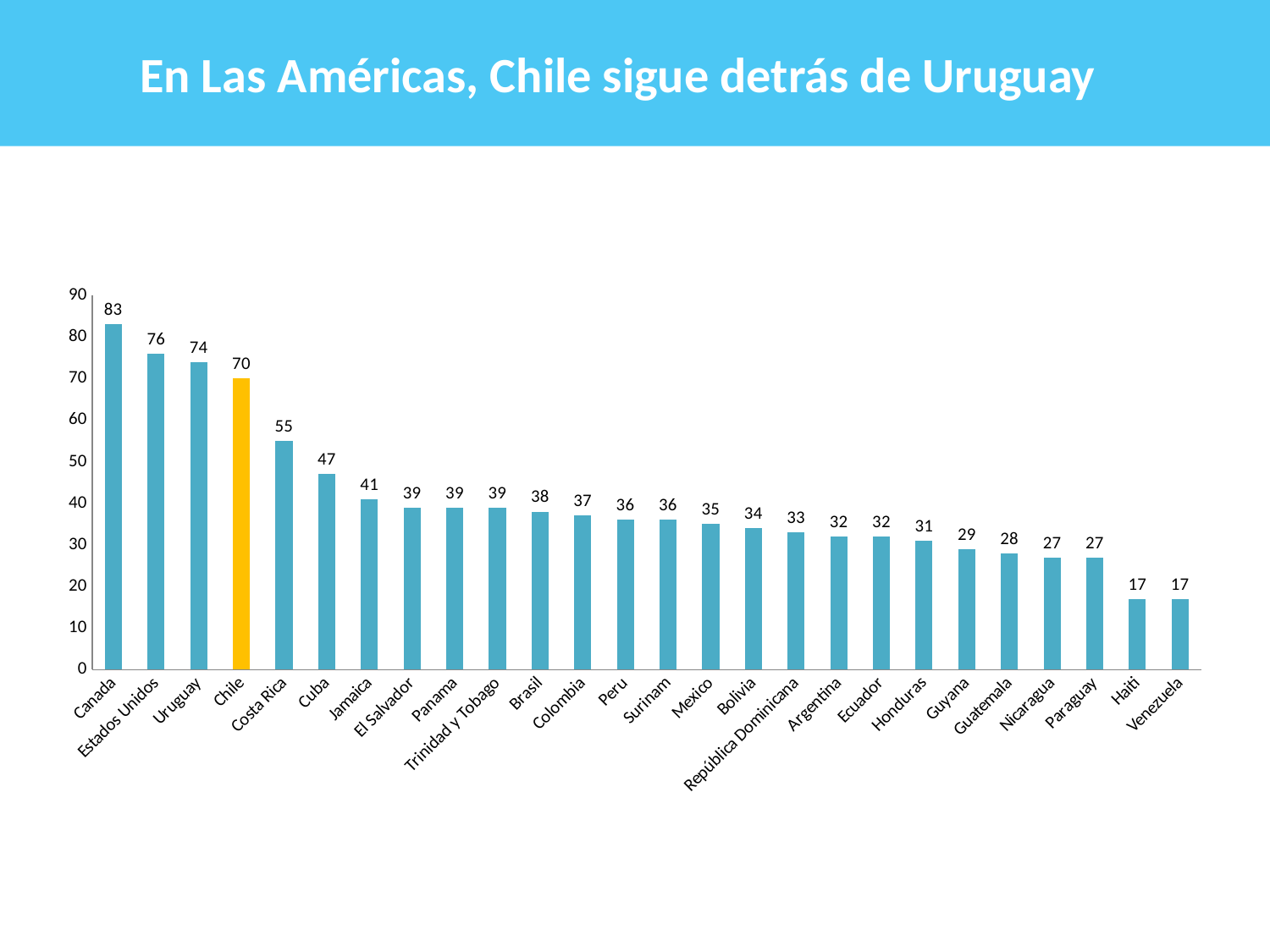
What is the value for Costa Rica? 55 What is the value for Uruguay? 74 Which bar is highlighted in a different colour (yellow) from the others? Chile What kind of chart is shown on the slide? Bar chart Which country has the highest value? Canada Which has a larger value, Argentina or Brasil? Brasil Which has a larger value, Cuba or Jamaica? Cuba What is the difference between the values for Canada and Estados Unidos? 7 What is the value for Chile? 70 How many countries are shown in the chart? 26 What is the value for República Dominicana? 33 What is the difference between the values for Uruguay and Chile? 4